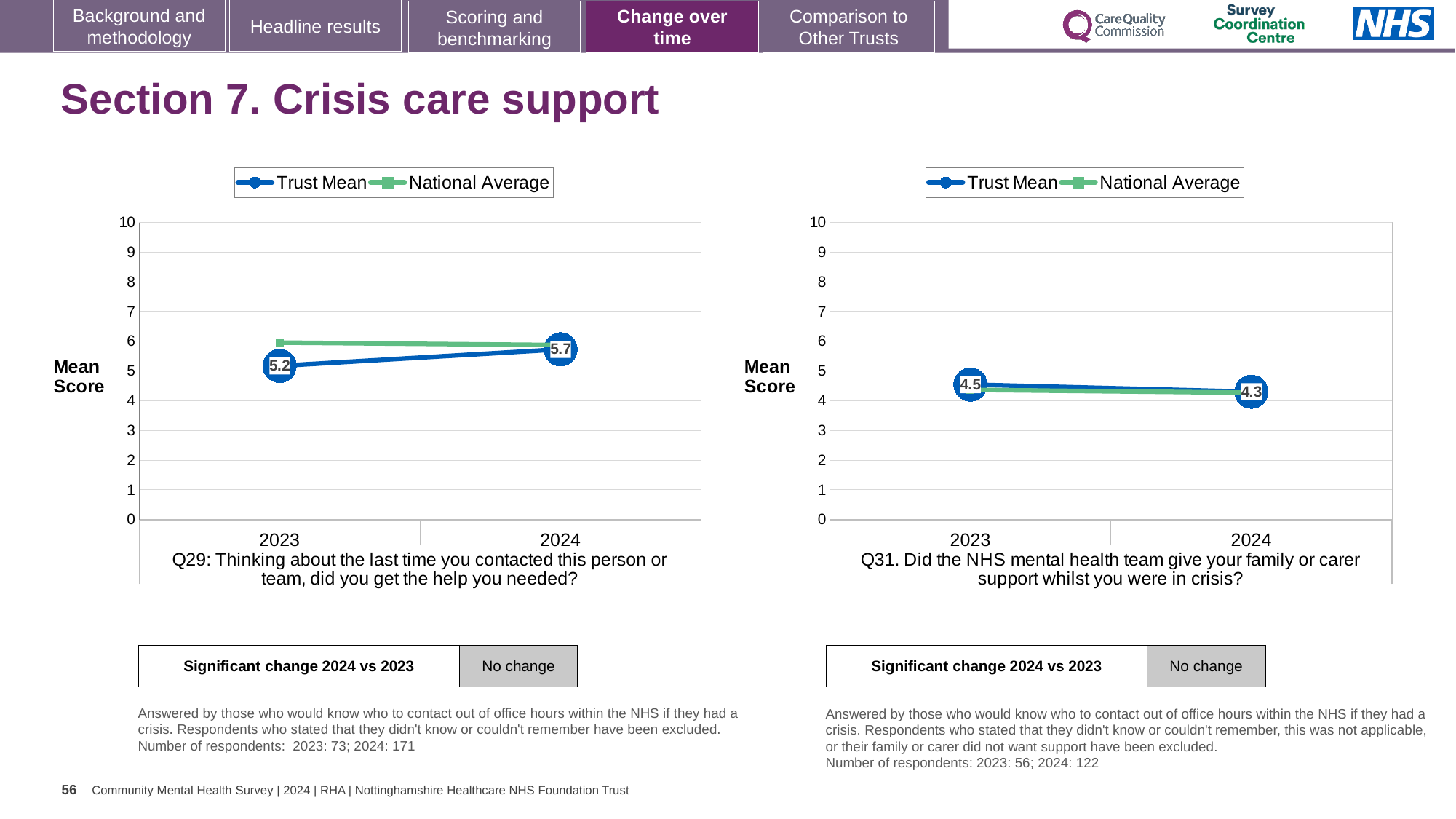
In the Q29 chart on the left, is the National Average value for 2023 greater or less than 5? greater In the Q29 chart on the left, what is the Trust Mean score for 2024? 5.7 In the Q31 chart on the right, what is the Trust Mean score for 2024? 4.3 In the Q29 chart on the left, what is the Trust Mean score for 2023? 5.2 In the Q31 chart on the right, what is the Trust Mean score for 2023? 4.5 In the Q31 chart on the right, what is the difference between the Trust Mean for 2023 and 2024? 0.2 What kind of chart is the Q31 chart on the right? line chart In the Q29 chart on the left, by how much did the Trust Mean change from 2023 to 2024? 0.5 How many series does the legend of the Q29 chart on the left list? 2 How many years are shown on the x axis of the Q31 chart on the right? 2 In the Q29 chart on the left, does the Trust Mean rise or fall from 2023 to 2024? rise In the Q31 chart on the right, does the Trust Mean rise or fall from 2023 to 2024? fall